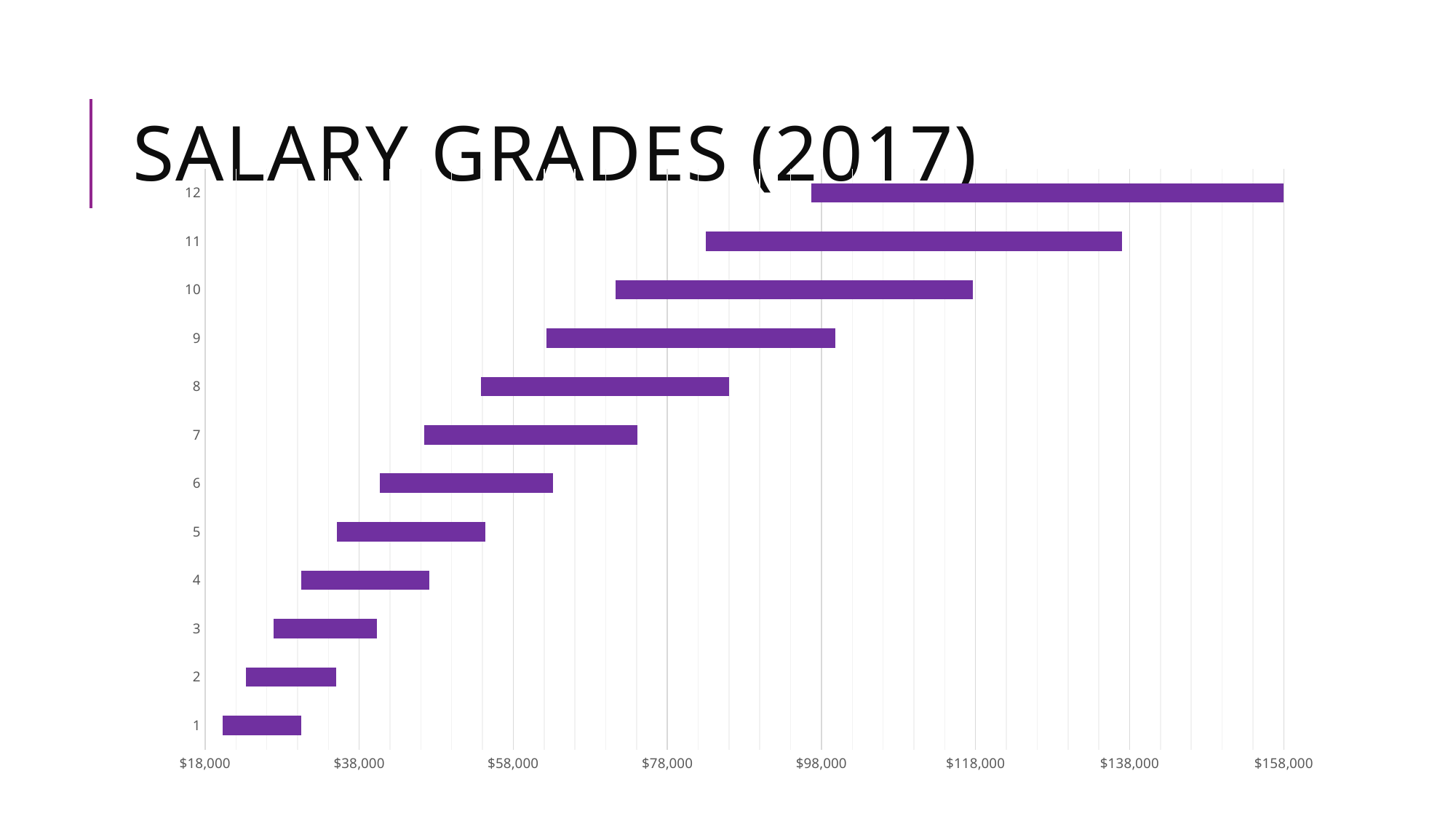
Which salary grade has the lowest salary range? 1 What is the title of the chart? SALARY GRADES (2017) Which has a higher upper salary value, grade 12 or grade 1? grade 12 Do the salary ranges rise or fall as the grade number increases? rise Is the lower end of the salary range for grade 9 greater or less than $78,000? less What kind of chart is shown on the slide? bar chart Is the lower end of the salary range for grade 11 greater or less than $78,000? greater How many salary grades are plotted on the chart? 12 Is the upper end of the salary range for grade 1 greater or less than $38,000? less Which salary grade has the highest upper salary value? 12